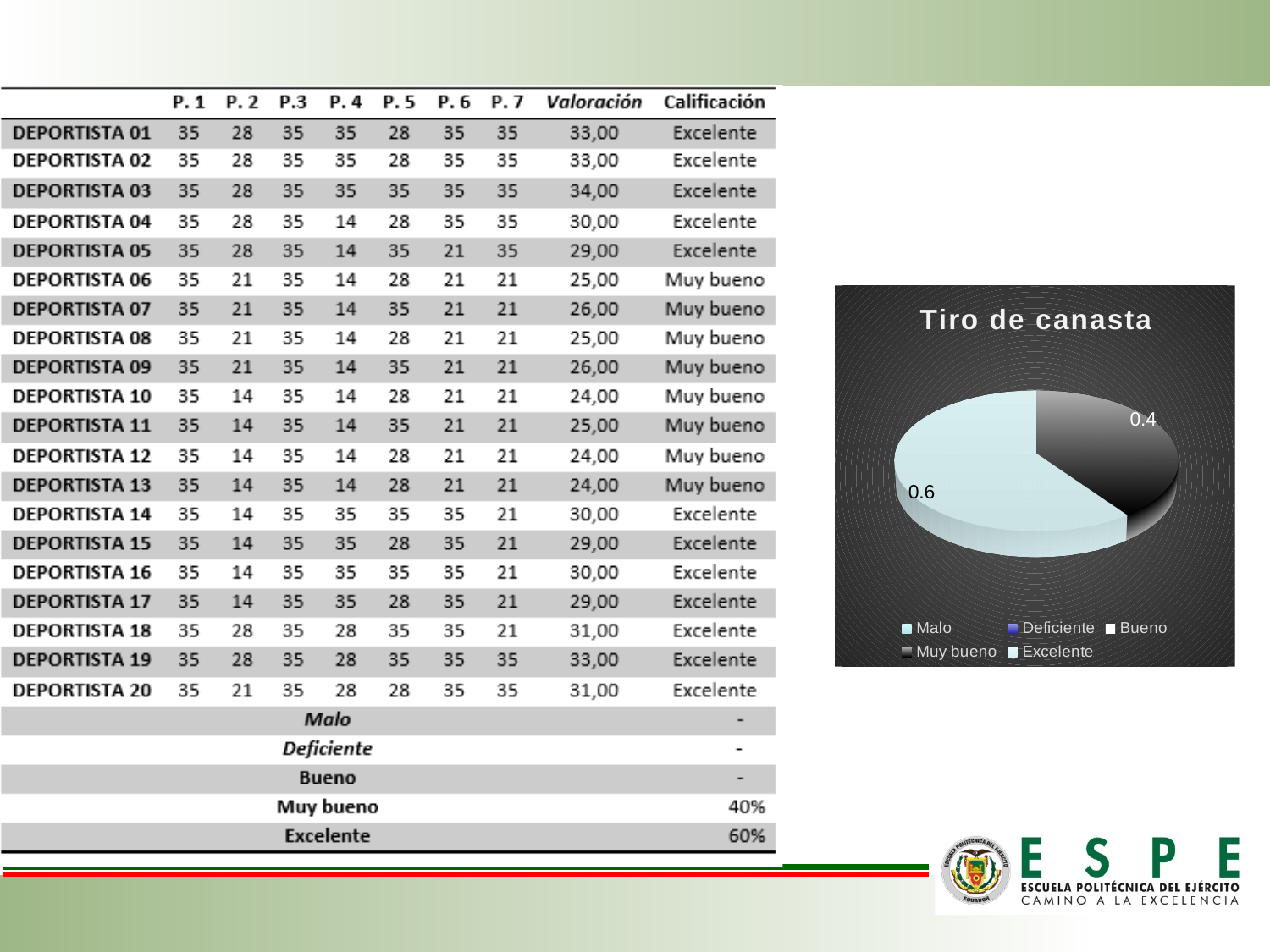
What kind of chart is shown on the slide? pie chart What is the value shown on the larger slice of the pie chart? 0.6 What is the value of the Muy bueno slice in the pie chart? 0.4 What is the title of the chart? Tiro de canasta Which is larger in the pie chart, the Excelente slice or the Muy bueno slice? Excelente Which category has the largest slice in the pie chart? Excelente How many entries does the chart's legend list? 5 What is the value of the Excelente slice in the pie chart? 0.6 Which legend entries are listed in the pie chart's legend? Malo, Deficiente, Bueno, Muy bueno, Excelente How many slices with data labels are visible in the pie chart? 2 What is the value shown on the smaller slice of the pie chart? 0.4 What is the difference between the two labelled slice values in the pie chart? 0.2